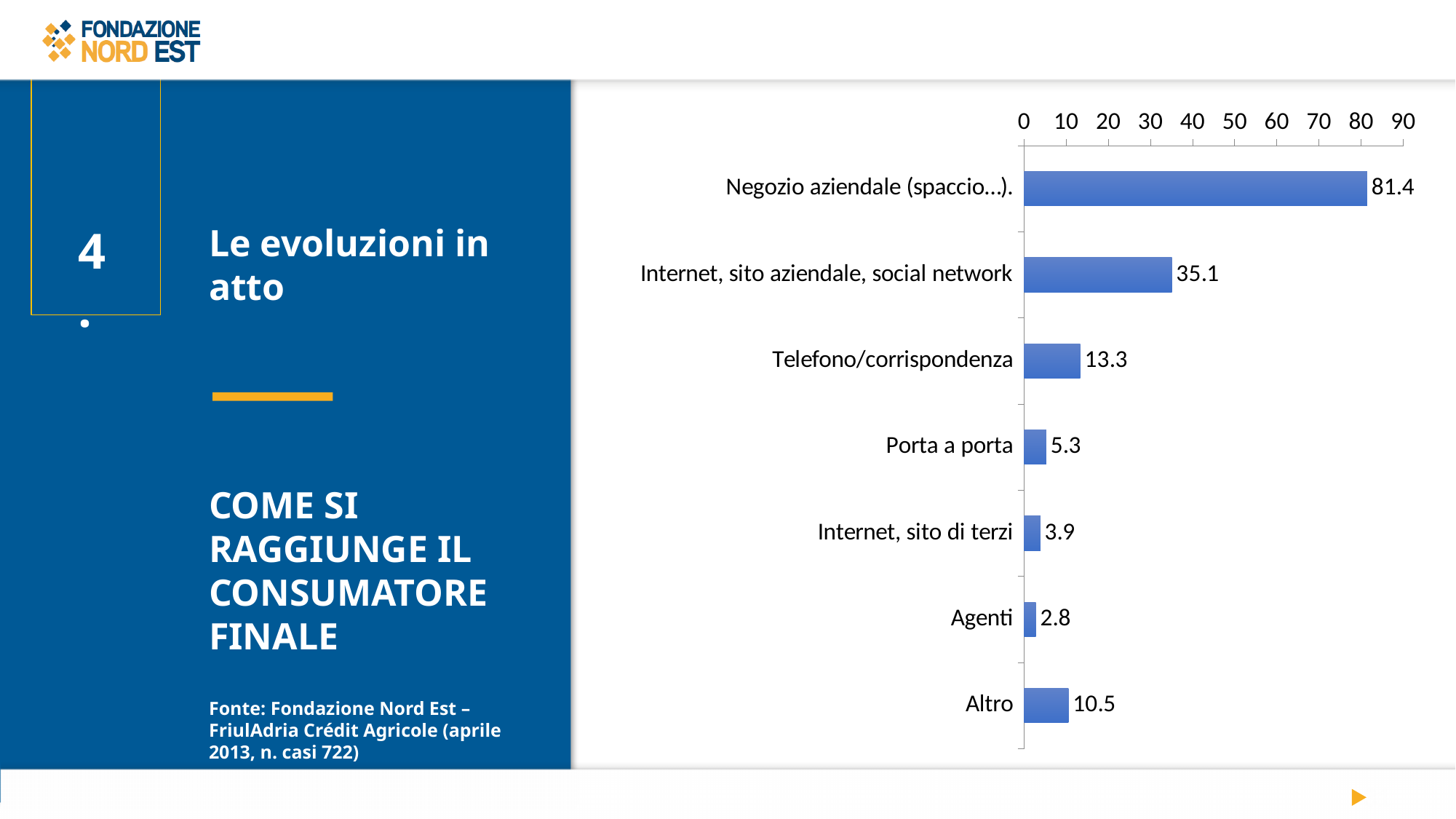
What kind of chart is shown on the slide? Bar chart What is the difference between the values for Negozio aziendale (spaccio...) and Internet, sito aziendale, social network? 46.3 Which is larger, the value for Porta a porta or the value for Altro? Altro How many categories are shown in the chart? 7 Is the value for Internet, sito aziendale, social network greater or less than 30? greater What is the value for Telefono/corrispondenza? 13.3 What is the value for Negozio aziendale (spaccio...)? 81.4 What is the value for Internet, sito aziendale, social network? 35.1 What is the value for Agenti? 2.8 Which category has the lowest value? Agenti Which category has the highest value? Negozio aziendale (spaccio...) What is the difference between the values for Internet, sito di terzi and Agenti? 1.1